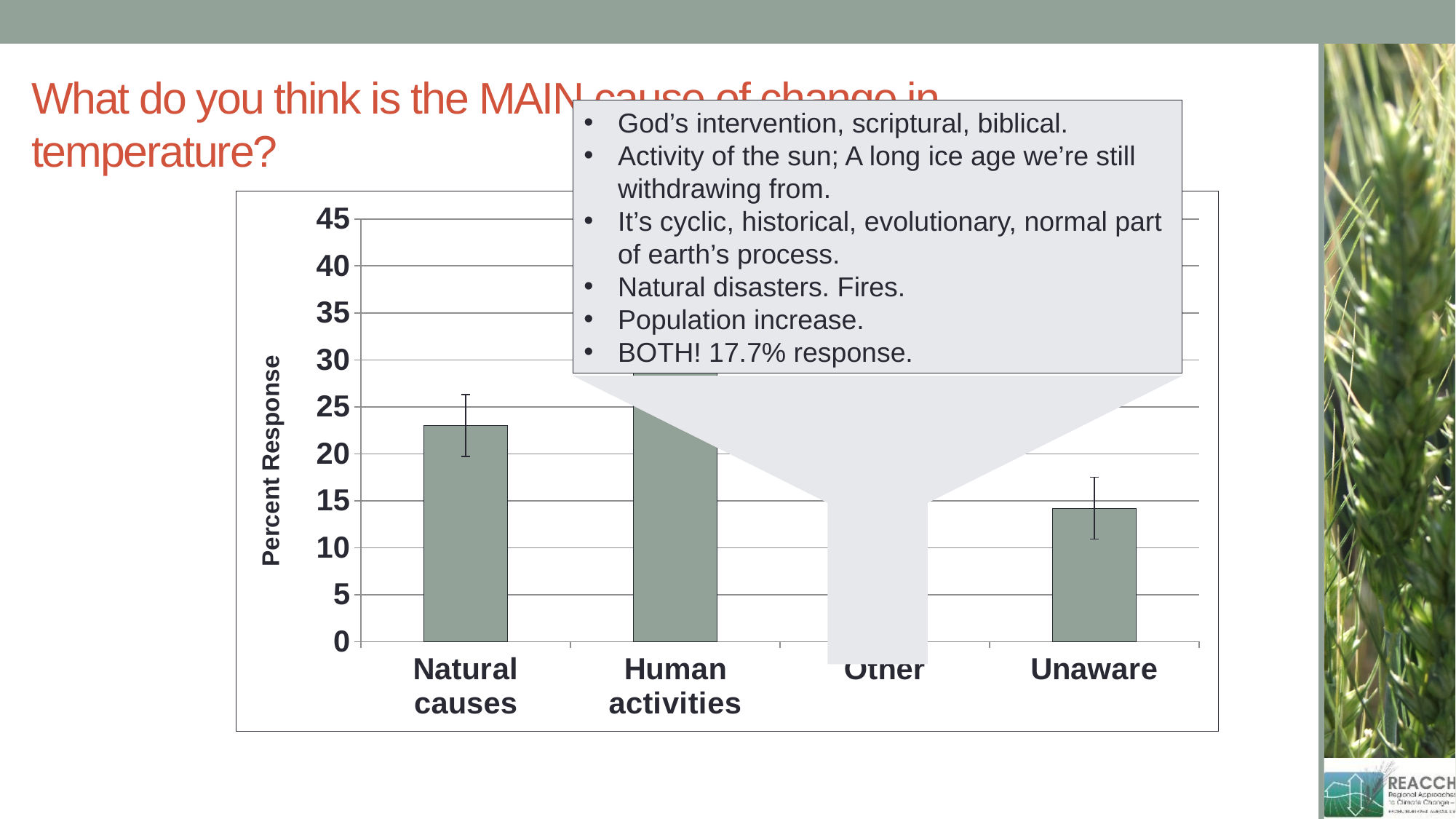
Is the value for Natural causes greater or less than 20? greater Which is larger, the value for Natural causes or the value for Unaware? Natural causes What kind of chart is shown on the slide? bar chart What is the highest value shown on the y axis of the chart? 45 Is the value for Human activities greater or less than 25? greater What is the label of the y axis of the chart? Percent Response Which is larger, the value for Human activities or the value for Natural causes? Human activities Is the value for Natural causes greater or less than 25? less How many categories are shown on the x axis of the chart? 4